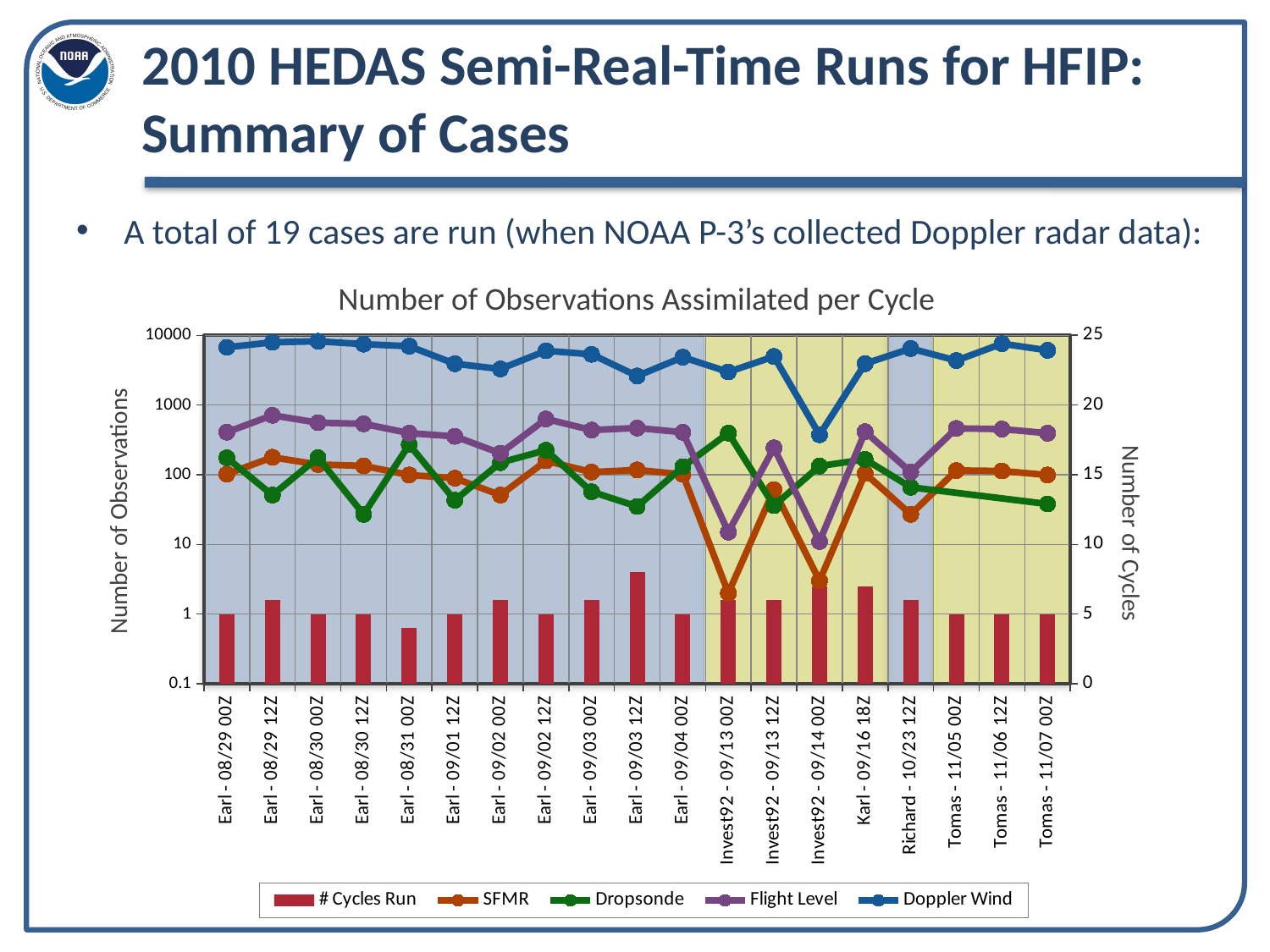
Which case has the lowest SFMR value? Invest92 - 09/13 00Z How many cycles were run for Earl - 08/29 00Z according to the bar? 5 Which series is plotted as bars in the chart? # Cycles Run Is the Dropsonde value for Earl - 08/30 12Z greater or less than 100? less What kind of chart is shown on the slide? Combined bar and line chart Which case has the highest number of cycles run? Earl - 09/03 12Z Which case has the lowest Doppler Wind value? Invest92 - 09/14 00Z What is the title of the chart? Number of Observations Assimilated per Cycle How many cases (categories) are shown along the x axis of the chart? 19 Is the Doppler Wind value for Invest92 - 09/14 00Z greater or less than 1000? less How many series does the chart legend list? 5 For Earl - 08/29 12Z, which is larger: the Flight Level value or the Dropsonde value? Flight Level